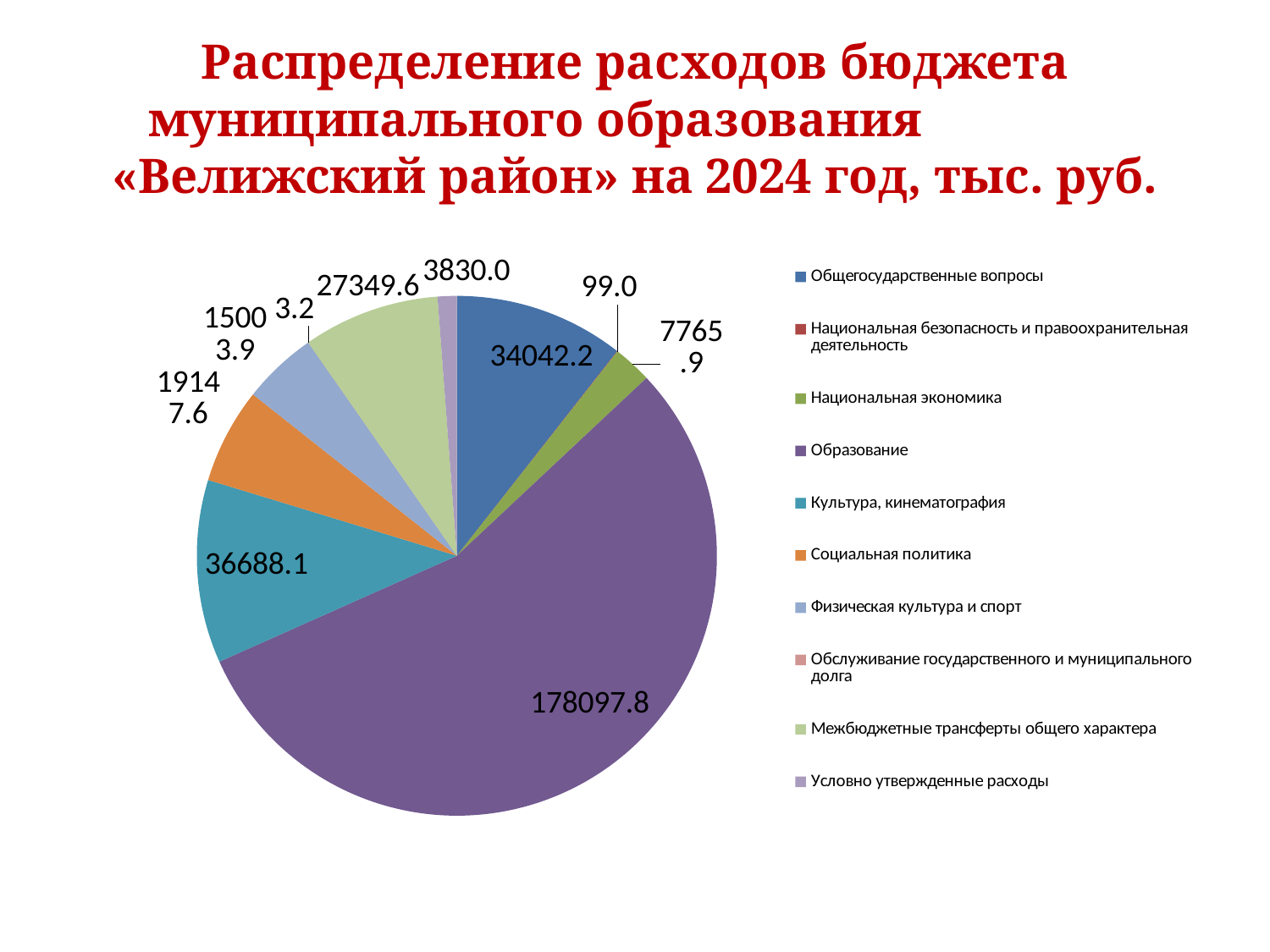
What is the value for Образование? 178097.8 What is the value for Культура, кинематография? 36688.1 Which category has the smallest value in the pie chart? Обслуживание государственного и муниципального долга What is the value for Условно утвержденные расходы? 3830.0 Which is larger: Культура, кинематография or Общегосударственные вопросы? Культура, кинематография What is the value for Общегосударственные вопросы? 34042.2 What is the difference between the values for Культура, кинематография and Общегосударственные вопросы? 2645.9 What is the value for Национальная безопасность и правоохранительная деятельность? 99.0 How many categories does the legend of the pie chart list? 10 What kind of chart is shown on the slide? pie chart Which category has the largest slice of the pie? Образование What is the value for Межбюджетные трансферты общего характера? 27349.6